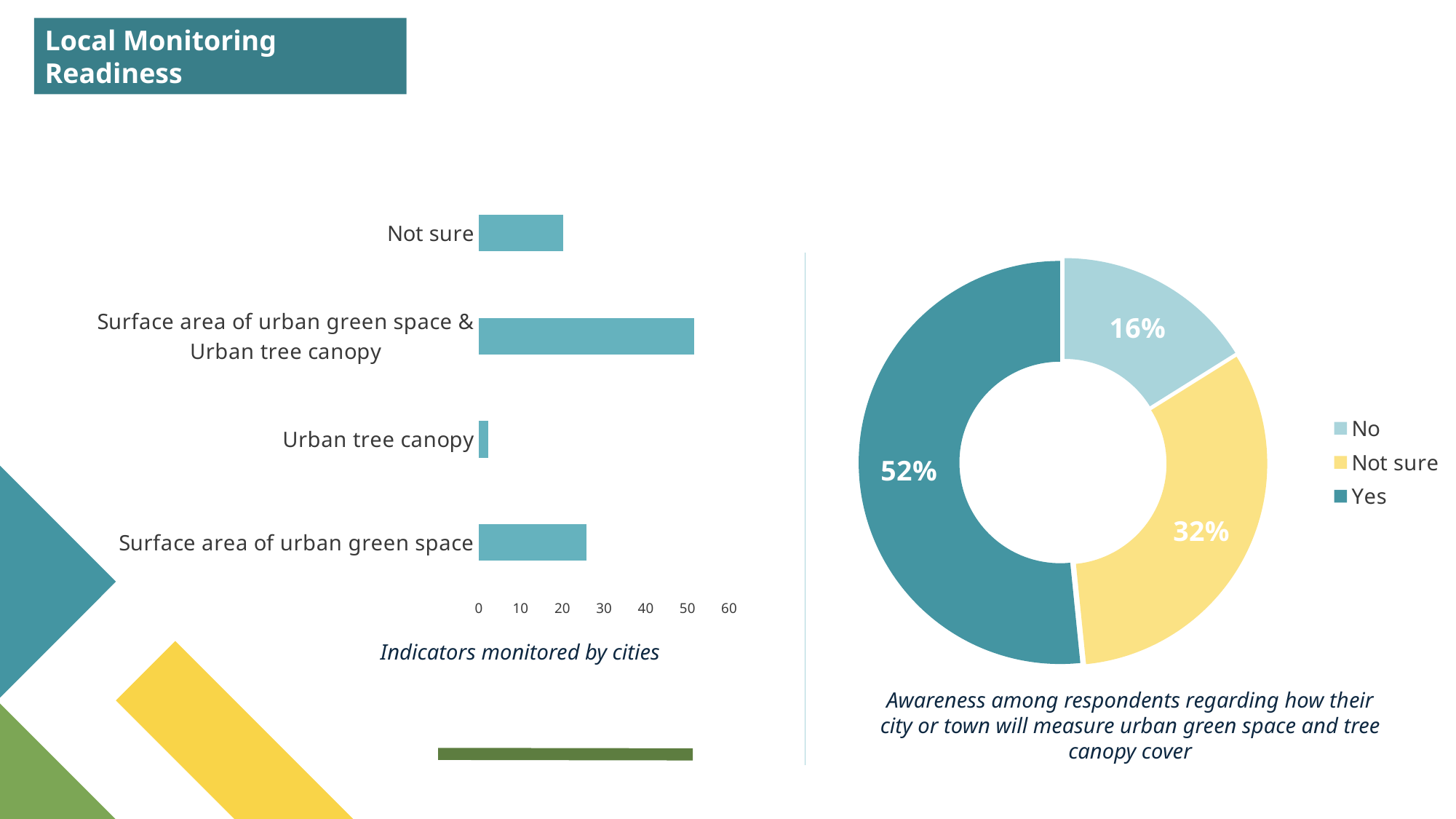
In the donut chart on the right, what percentage of respondents answered 'No'? 16% In the donut chart on the right, which response has the smallest share? No In the 'Indicators monitored by cities' chart, which is larger: 'Surface area of urban green space' or 'Not sure'? Surface area of urban green space In the 'Indicators monitored by cities' chart, is the value for 'Urban tree canopy' greater or less than 10? less In the 'Indicators monitored by cities' chart, what kind of chart is shown? bar chart In the donut chart on the right, how many entries does the legend list? 3 In the donut chart on the right, what is the difference between the 'Yes' and 'Not sure' shares? 20% In the 'Indicators monitored by cities' chart, is the value for 'Surface area of urban green space & Urban tree canopy' greater or less than 40? greater In the donut chart on the right, what percentage of respondents answered 'Yes'? 52% In the 'Indicators monitored by cities' chart, how many categories are shown? 4 In the 'Indicators monitored by cities' chart, which category has the lowest value? Urban tree canopy In the 'Indicators monitored by cities' chart, which category has the highest value? Surface area of urban green space & Urban tree canopy